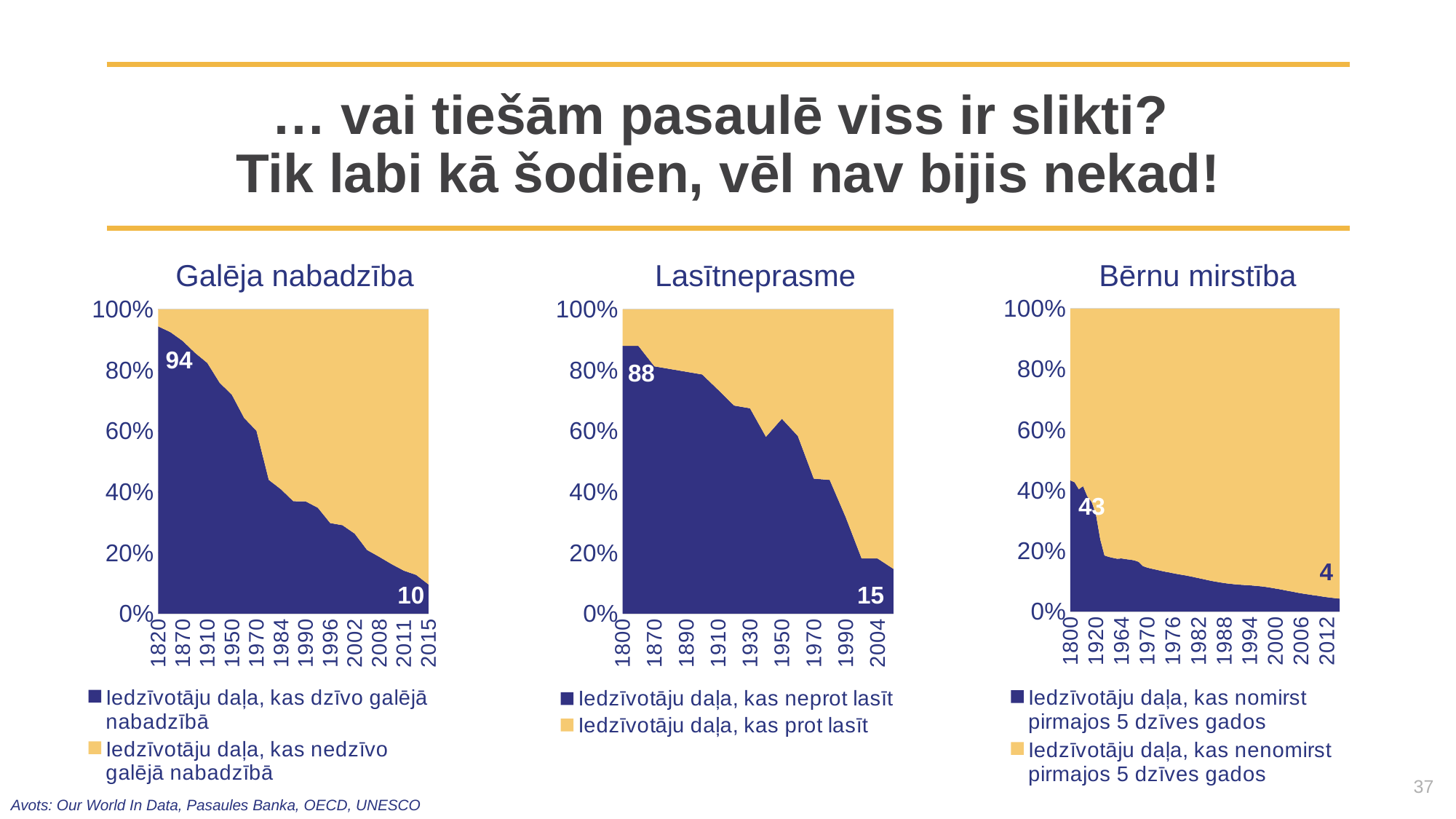
On the Galēja nabadzība chart, is the dark blue value for 1950 greater or less than 60%? greater On the Galēja nabadzība chart, what is the labelled value for 1820? 94 On the Bērnu mirstība chart, what is the difference between the labelled values for 1800 and 2012? 39 How many series does the legend of the Bērnu mirstība chart list? 2 On the Galēja nabadzība chart, what is the labelled value for 2015? 10 On the Bērnu mirstība chart, what is the labelled value for 1800? 43 On the Galēja nabadzība chart, what is the difference between the labelled values for 1820 and 2015? 84 What kind of chart is the Lasītneprasme chart? stacked area chart On the Lasītneprasme chart, does the dark blue series rise or fall from 1800 to 2004? fall On the Lasītneprasme chart, what is the labelled value for 1800? 88 On the Bērnu mirstība chart, what is the labelled value for 2012? 4 On the Lasītneprasme chart, what is the labelled value for 2004? 15